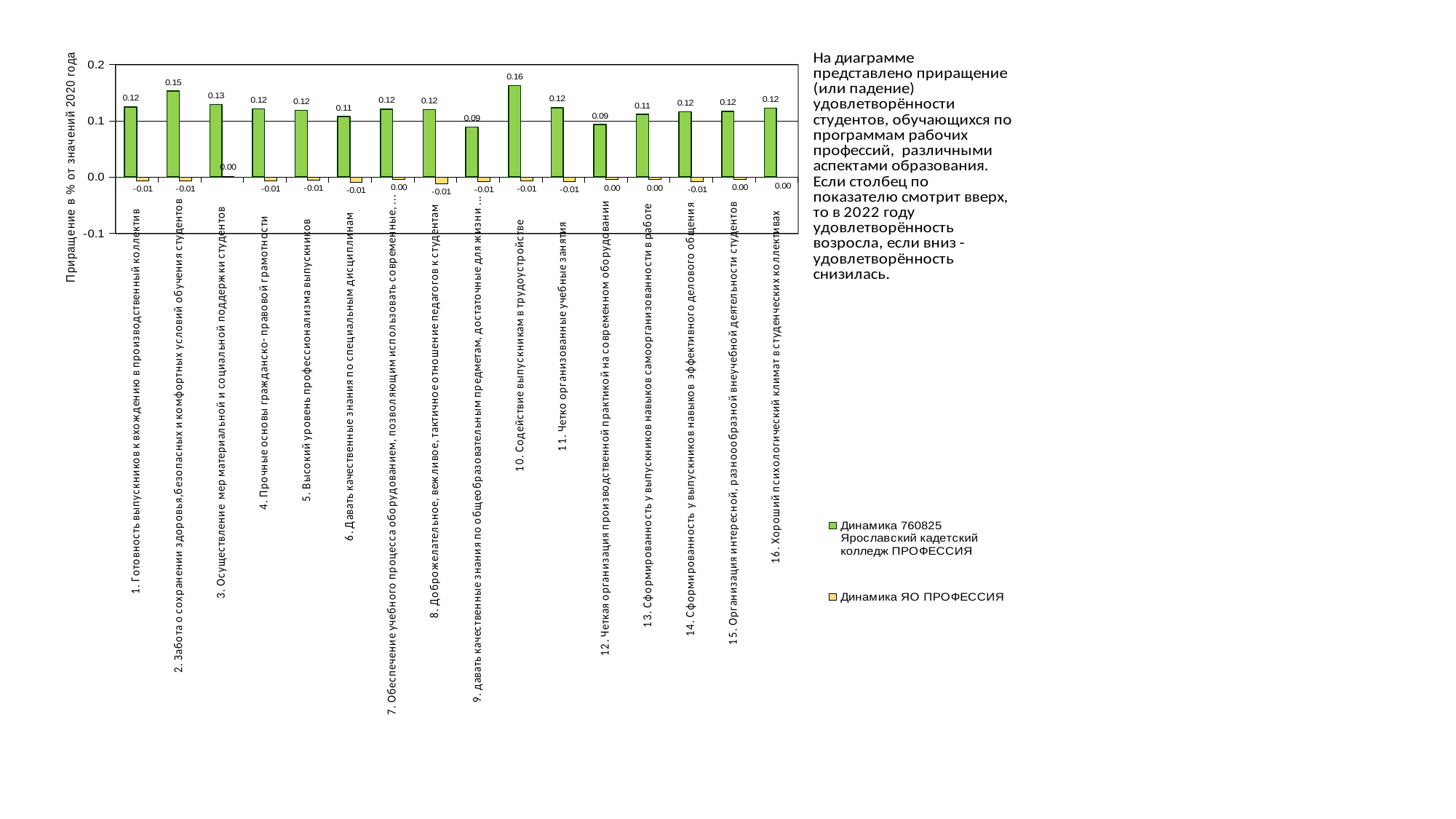
How many categories are shown on the x axis of the chart? 16 Is the value of 'Динамика 760825 Ярославский кадетский колледж ПРОФЕССИЯ' for category '12. Четкая организация производственной практикой на современном оборудовании' greater or less than 0.1? less What is the value of the series 'Динамика 760825 Ярославский кадетский колледж ПРОФЕССИЯ' for category '2. Забота о сохранении здоровья, безопасных и комфортных условий обучения студентов'? 0.15 What is the label of the y axis of the chart? Приращение в % от значений 2020 года What is the value of the series 'Динамика 760825 Ярославский кадетский колледж ПРОФЕССИЯ' for category '10. Содействие выпускникам в трудоустройстве'? 0.16 How many series does the legend list? 2 Which is larger for the series 'Динамика 760825 Ярославский кадетский колледж ПРОФЕССИЯ': the value for category 3 (Осуществление мер материальной и социальной поддержки студентов) or category 6 (Давать качественные знания по специальным дисциплинам)? category 3 (0.13) What is the value of the series 'Динамика ЯО ПРОФЕССИЯ' for category '1. Готовность выпускников к вхождению в производственный коллектив'? -0.01 Which category has the highest value for the series 'Динамика 760825 Ярославский кадетский колледж ПРОФЕССИЯ'? 10. Содействие выпускникам в трудоустройстве What kind of chart is shown on the slide? bar chart What is the difference between the 'Динамика 760825 Ярославский кадетский колледж ПРОФЕССИЯ' values for category 10 (Содействие выпускникам в трудоустройстве) and category 9 (давать качественные знания по общеобразовательным предметам)? 0.07 What is the value of the series 'Динамика ЯО ПРОФЕССИЯ' for category '16. Хороший психологический климат в студенческих коллективах'? 0.00